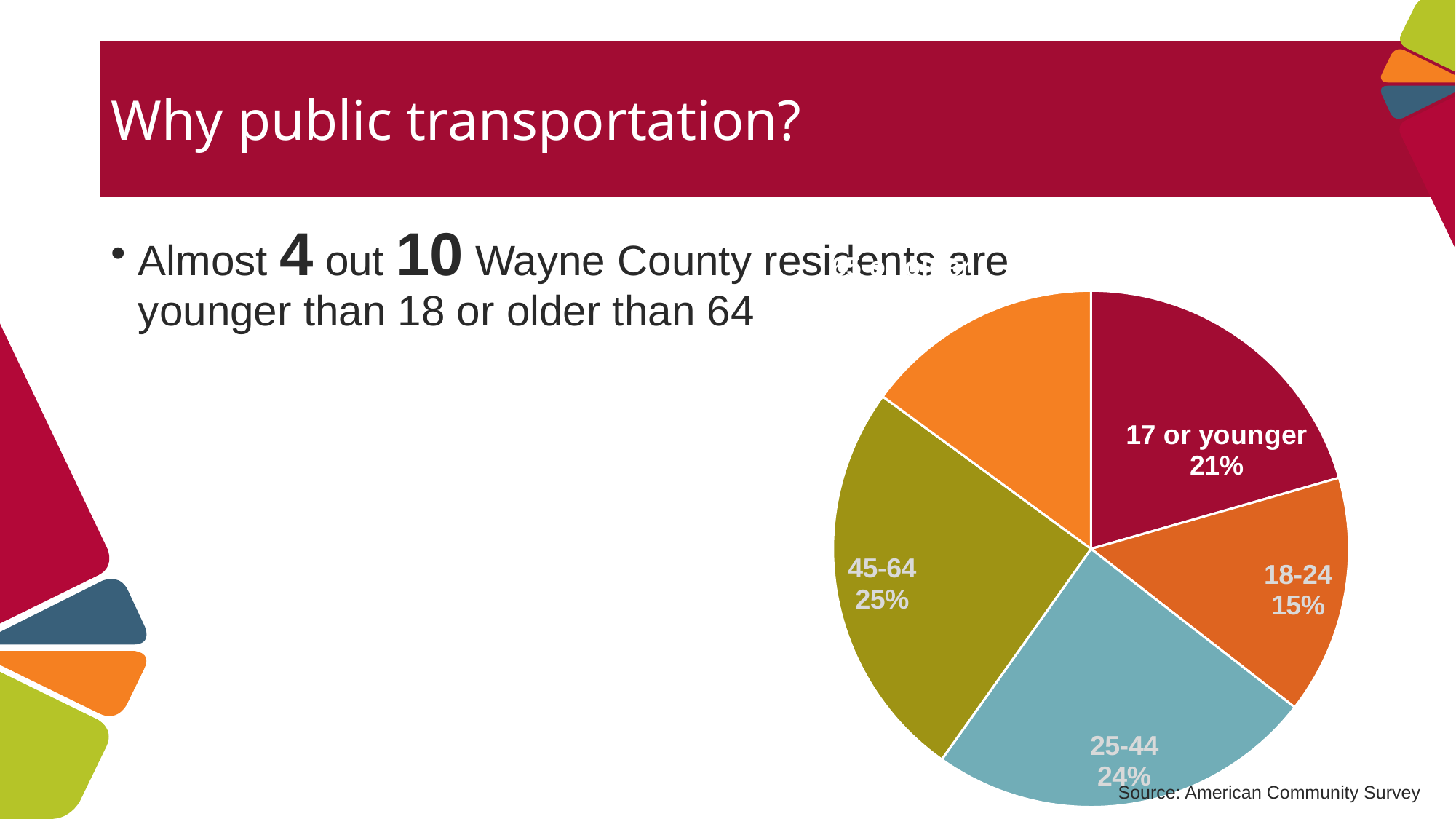
Which is larger, the 25-44 slice or the 18-24 slice? 25-44 What is the difference in percentage points between the 45-64 slice and the 18-24 slice? 10 What kind of chart is shown on the slide? Pie chart What colour is the 25-44 slice of the pie chart? Light blue What percentage of Wayne County residents are 17 or younger according to the pie chart? 21% Which labelled age group has the largest share in the pie chart? 45-64 What share of the pie chart is the 18-24 age group? 15% What percentage does the 45-64 slice show? 25% How many slices does the pie chart have? 5 What percentage does the 25-44 slice show? 24% Which is larger, the 17 or younger slice or the 18-24 slice? 17 or younger What is the difference in percentage points between the 17 or younger slice and the 25-44 slice? 3